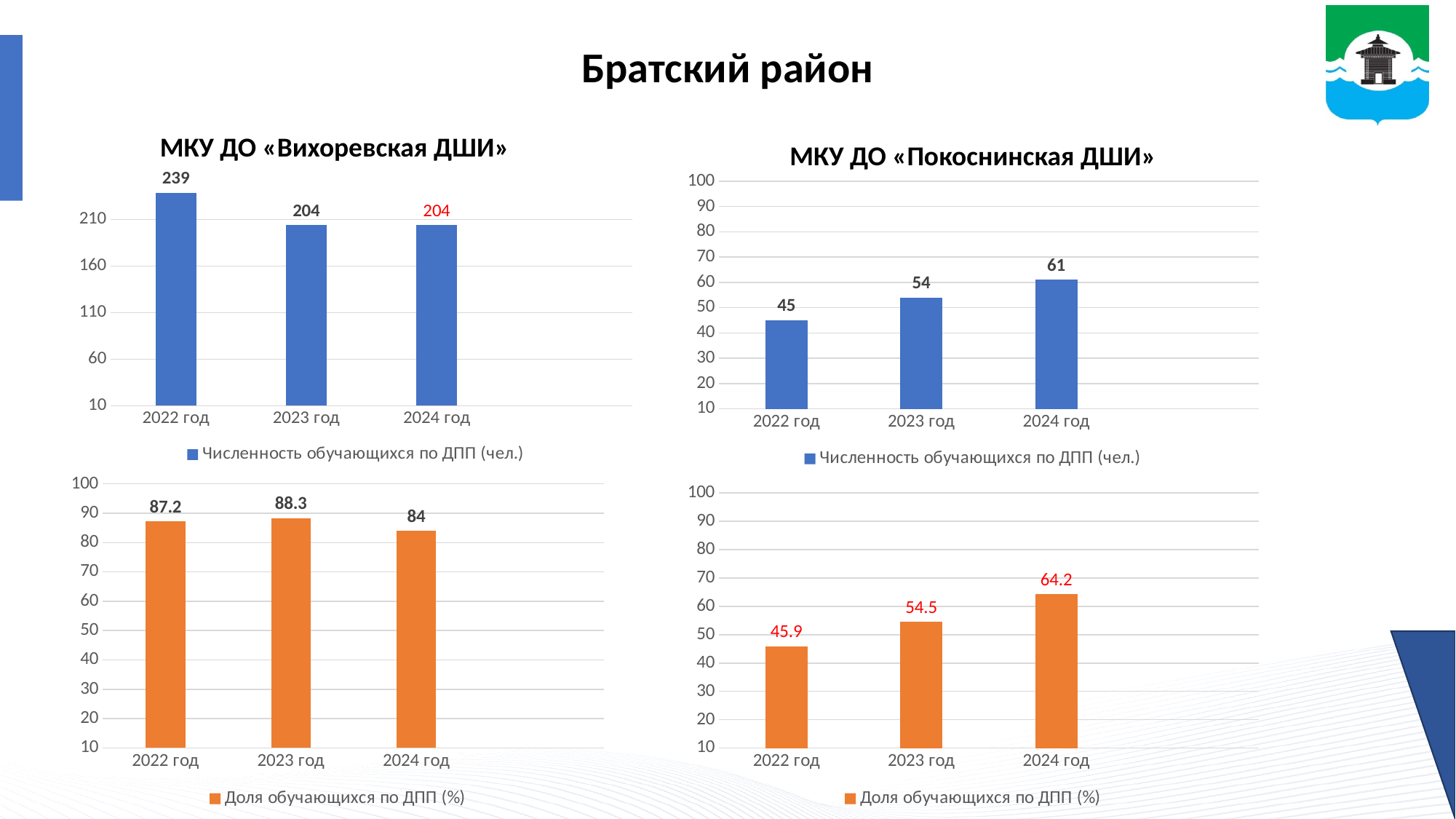
In the top-right chart (МКУ ДО «Покоснинская ДШИ», Численность обучающихся по ДПП), what is the difference between the values for 2024 год and 2022 год? 16 In the bottom-right chart (Покоснинская ДШИ, Доля обучающихся по ДПП (%)), which is larger, the value for 2023 год or 2024 год? 2024 год In the bottom-right chart (Покоснинская ДШИ, Доля обучающихся по ДПП (%)), what is the value for 2022 год? 45.9 In the top-left chart (МКУ ДО «Вихоревская ДШИ», Численность обучающихся по ДПП), what is the difference between the values for 2022 год and 2023 год? 35 In the bottom-left chart (Вихоревская ДШИ, Доля обучающихся по ДПП (%)), which year has the lowest value? 2024 год In the bottom-left chart (Вихоревская ДШИ, Доля обучающихся по ДПП (%)), what is the value for 2023 год? 88.3 In the top-left chart (МКУ ДО «Вихоревская ДШИ», Численность обучающихся по ДПП), what is the value for 2022 год? 239 What kind of chart is the top-left chart (МКУ ДО «Вихоревская ДШИ»)? bar chart How many bars are there in the bottom-right chart (Покоснинская ДШИ, Доля обучающихся по ДПП (%))? 3 In the top-right chart (МКУ ДО «Покоснинская ДШИ», Численность обучающихся по ДПП), do the values rise or fall from 2022 год to 2024 год? rise In the top-left chart (МКУ ДО «Вихоревская ДШИ», Численность обучающихся по ДПП), which year has the highest value? 2022 год In the top-right chart (МКУ ДО «Покоснинская ДШИ», Численность обучающихся по ДПП), what is the value for 2024 год? 61